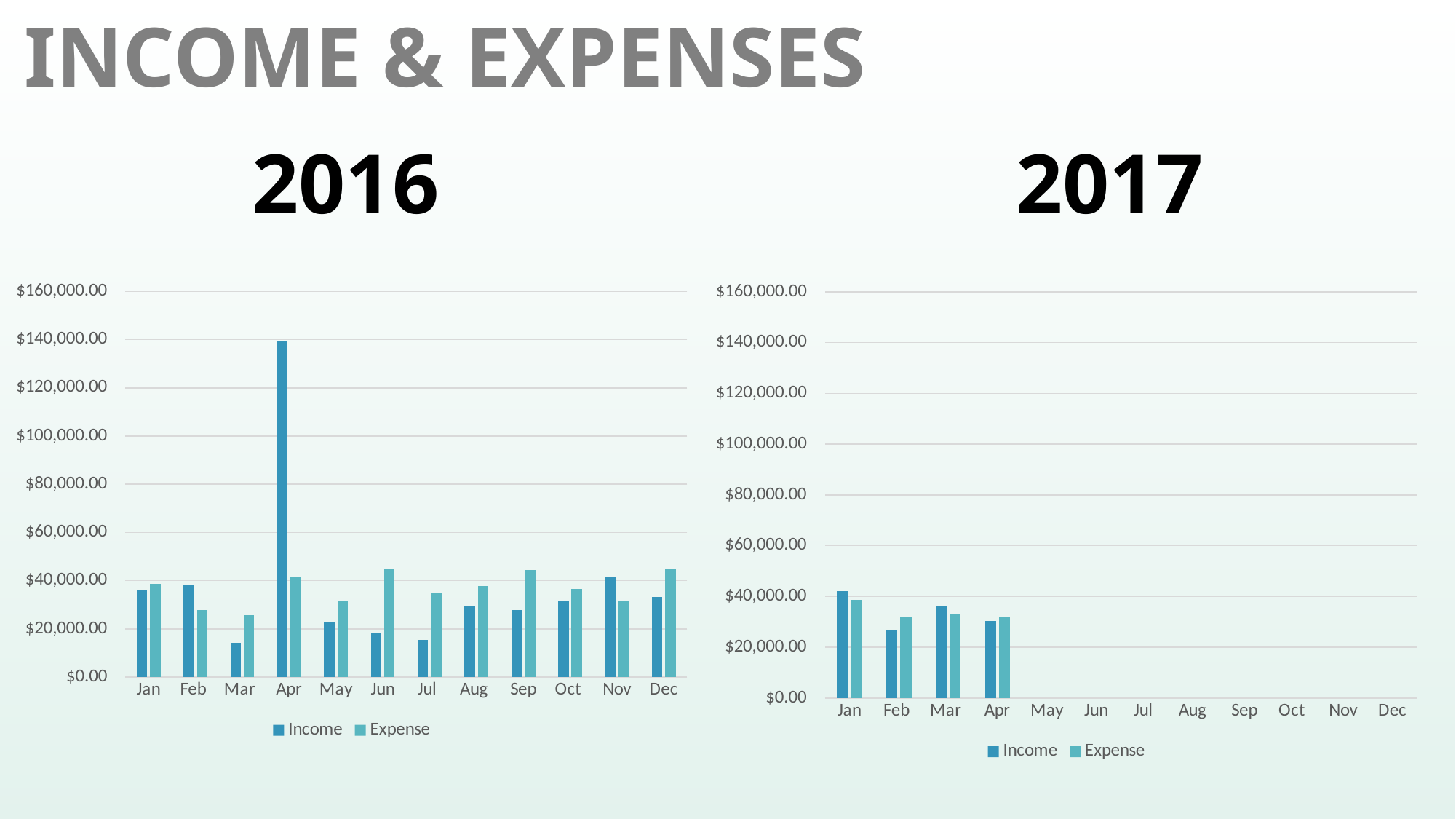
In the 2016 chart, which month has the highest Income? Apr In the 2017 chart, which month has the lowest Income? Feb In the 2016 chart, which is larger for Jul: Income or Expense? Expense In the 2017 chart, is the Income value for Jan greater or less than $40,000.00? greater In the 2016 chart, is the Income value for Apr greater or less than $120,000.00? greater What are the two series named in the legend of the 2016 chart? Income and Expense In the 2016 chart, is the Income value for Mar greater or less than $20,000.00? less In the 2017 chart, which month has the highest Income? Jan In the 2017 chart, how many months have bars plotted? 4 What kind of chart is the 2016 chart? bar chart How many series does the legend of the 2017 chart list? 2